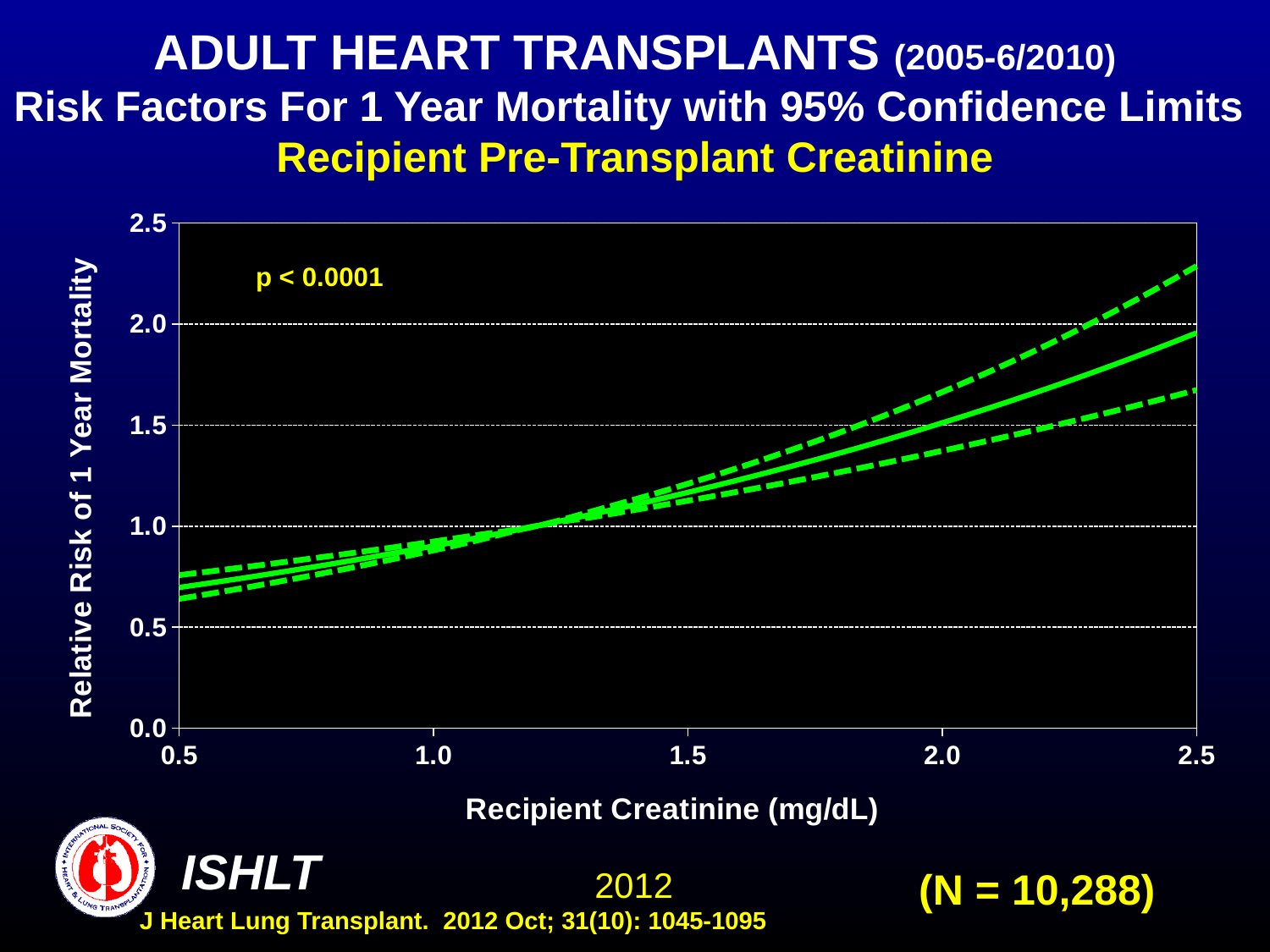
Is the upper 95% confidence limit at a recipient creatinine of 2.5 mg/dL greater or less than 2.0? greater Does the relative risk of 1 year mortality rise or fall as recipient creatinine increases from 0.5 to 2.5 mg/dL? rise Is the relative risk (solid line) at a recipient creatinine of 2.5 mg/dL greater or less than 1.5? greater What kind of chart is shown on the slide? line chart How many lines are plotted on the chart? 3 Is the lower 95% confidence limit at a recipient creatinine of 2.5 mg/dL greater or less than 2.0? less What p-value is shown on the chart? p < 0.0001 Which has the higher relative risk of 1 year mortality: a recipient creatinine of 1.0 mg/dL or 2.0 mg/dL? 2.0 mg/dL